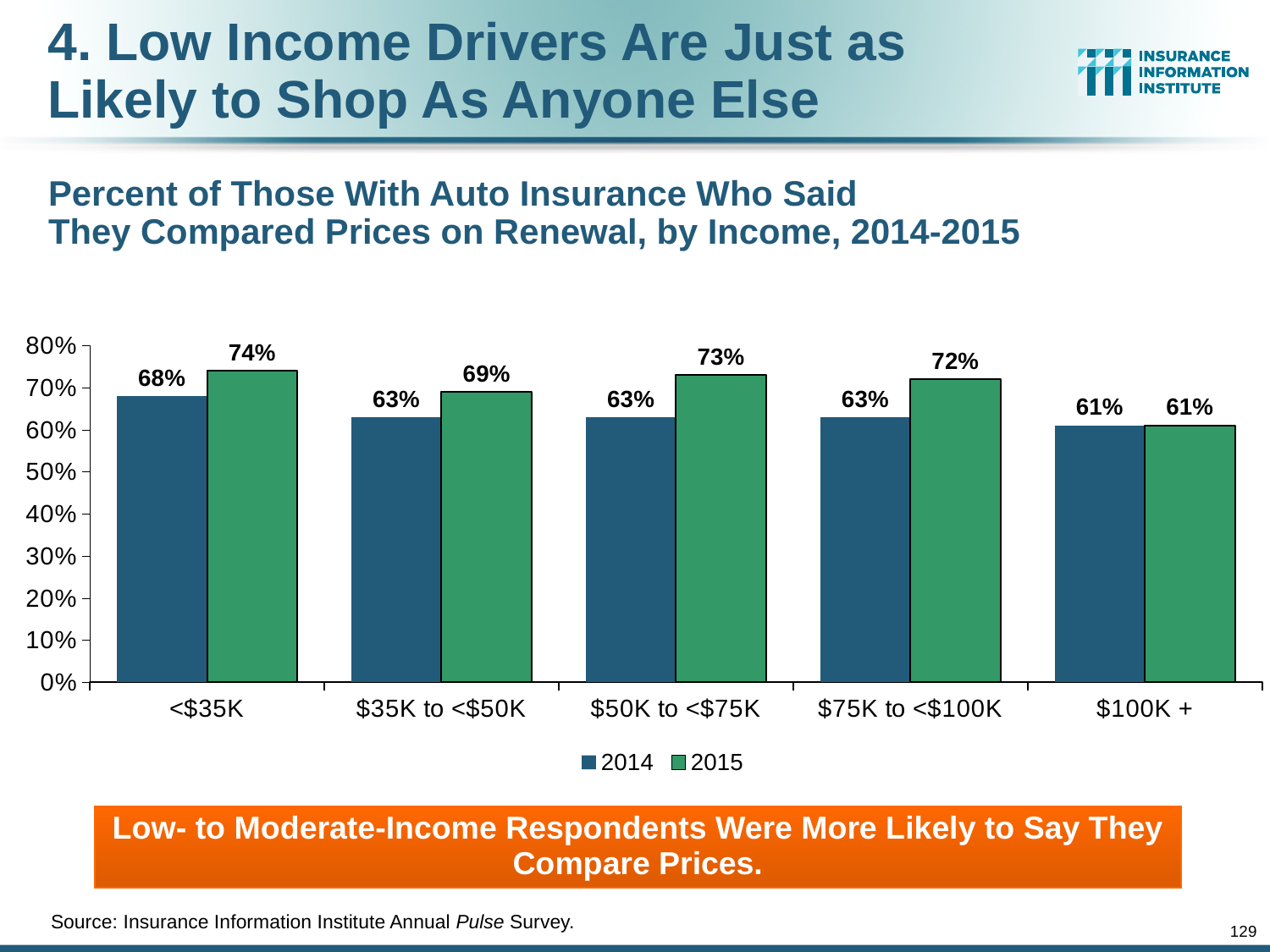
Which years are listed in the chart legend? 2014 and 2015 What is the difference between the 2015 values for $50K to <$75K and $100K +? 12 percentage points How many income groups are shown on the x axis? 5 What kind of chart is shown on the slide? Bar chart What was the 2014 value for the $75K to <$100K income group? 63% What is the difference between the 2015 and 2014 values for the <$35K income group? 6 percentage points Which income group had the highest 2015 value? <$35K What percentage of respondents with income <$35K said they compared prices on renewal in 2015? 74% What was the 2015 value for the $100K + income group? 61% Which income group had the lowest 2014 value? $100K + How many series does the legend list? 2 Which is larger: the 2015 value for $35K to <$50K or the 2015 value for $75K to <$100K? $75K to <$100K